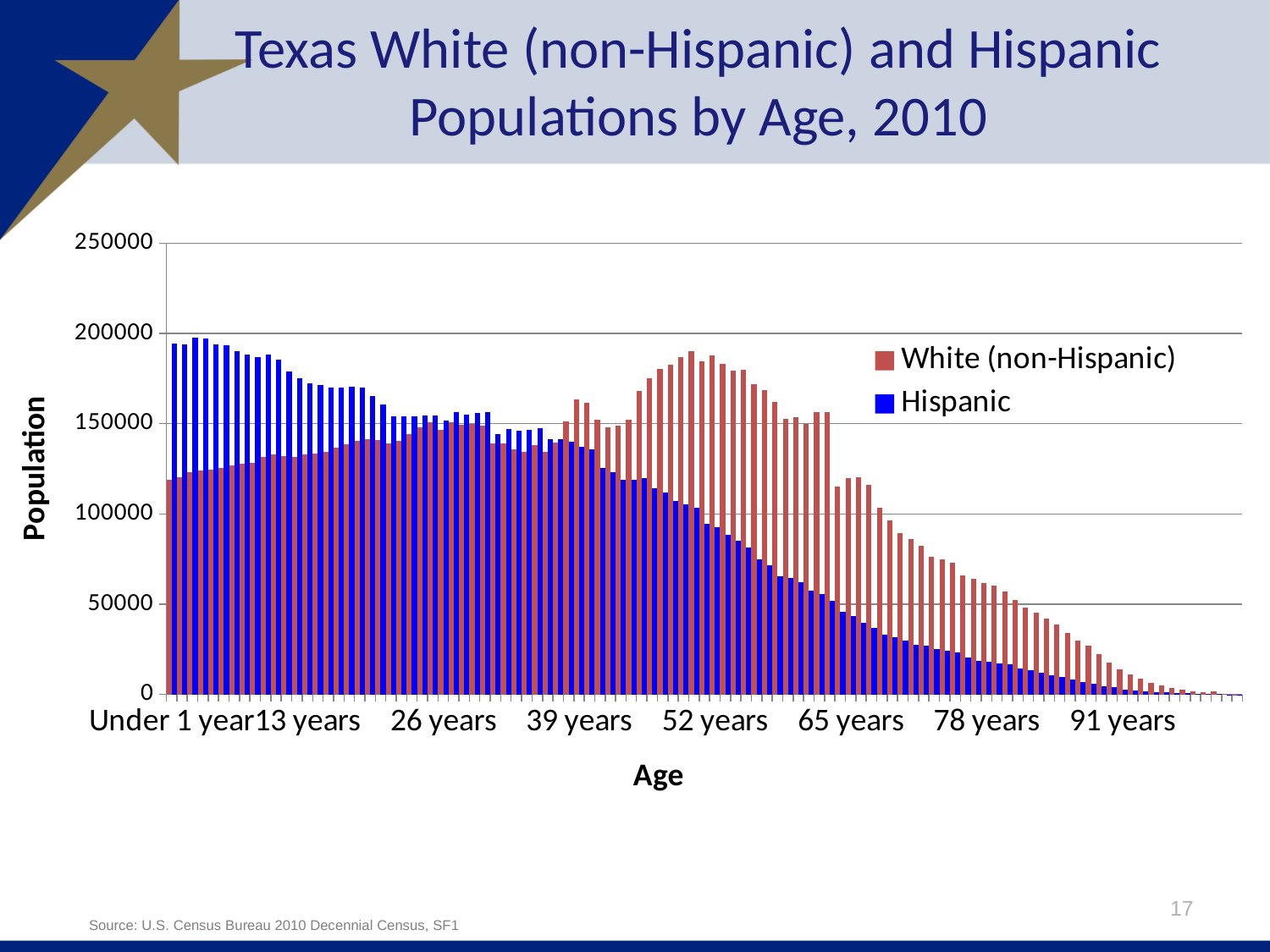
Does the Hispanic series generally rise or fall as age increases from 13 years to 91 years? fall Which colour represents the Hispanic series? blue Is the White (non-Hispanic) value for Under 1 year greater or less than 100000? greater At 52 years, which series has the larger value, White (non-Hispanic) or Hispanic? White (non-Hispanic) Is the Hispanic value for 78 years greater or less than 50000? less Is the Hispanic value for Under 1 year greater or less than 150000? greater At Under 1 year, which series has the larger value, White (non-Hispanic) or Hispanic? Hispanic How many series does the legend list? 2 What is the title of the chart? Texas White (non-Hispanic) and Hispanic Populations by Age, 2010 What kind of chart is shown on the slide? bar chart